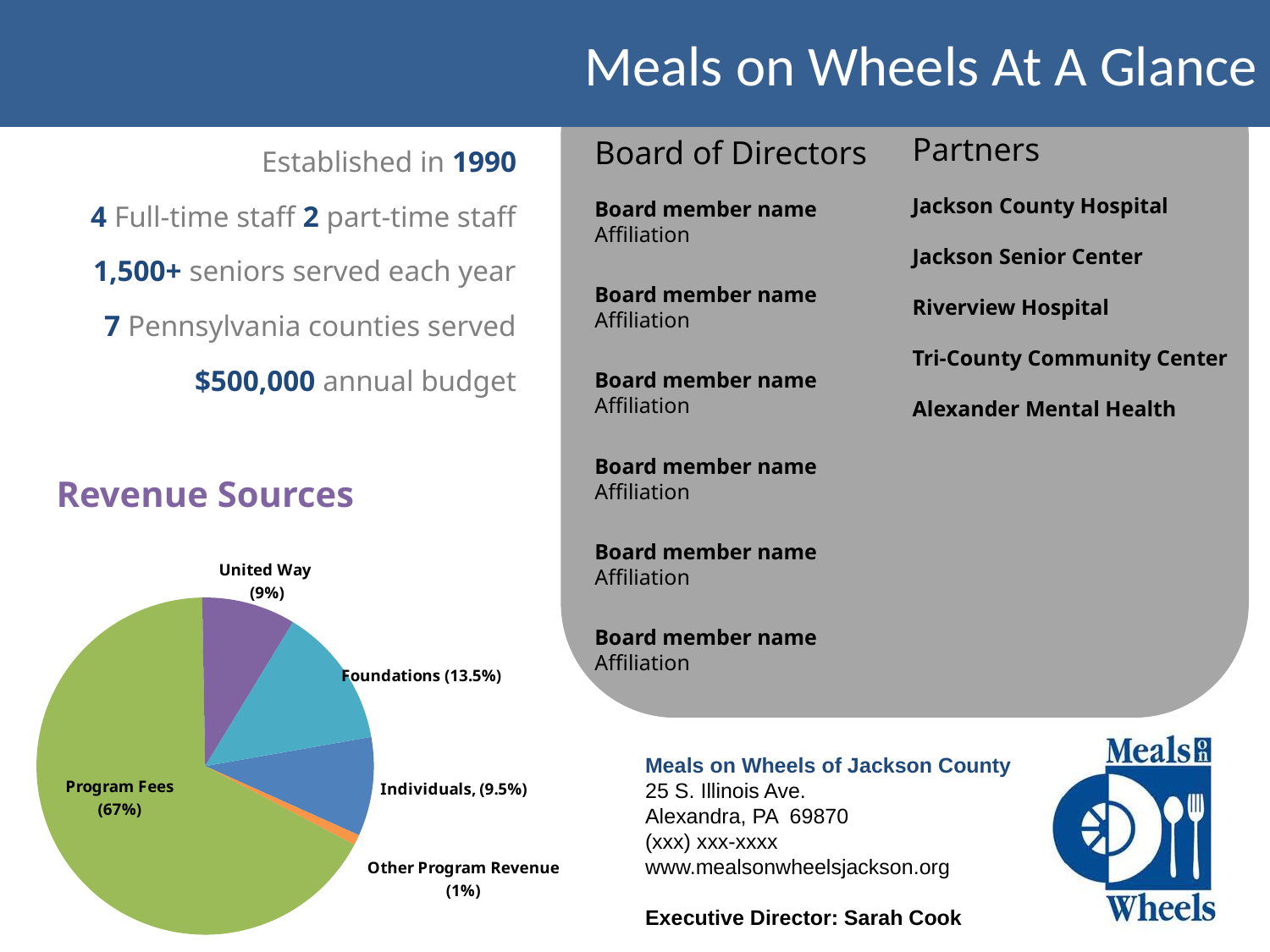
What share of revenue comes from United Way? 9% What share of revenue comes from Individuals? 9.5% What share of revenue comes from Other Program Revenue? 1% What is the title shown above the pie chart? Revenue Sources What share of revenue comes from Foundations? 13.5% What is the difference in percentage points between Program Fees and Foundations? 53.5 What type of chart is shown under the heading Revenue Sources? pie chart Which revenue source has the largest share of the pie? Program Fees Which is larger, the share for Foundations or the share for United Way? Foundations Which revenue source has the smallest share of the pie? Other Program Revenue How many revenue sources are shown in the pie chart? 5 What share of revenue comes from Program Fees? 67%